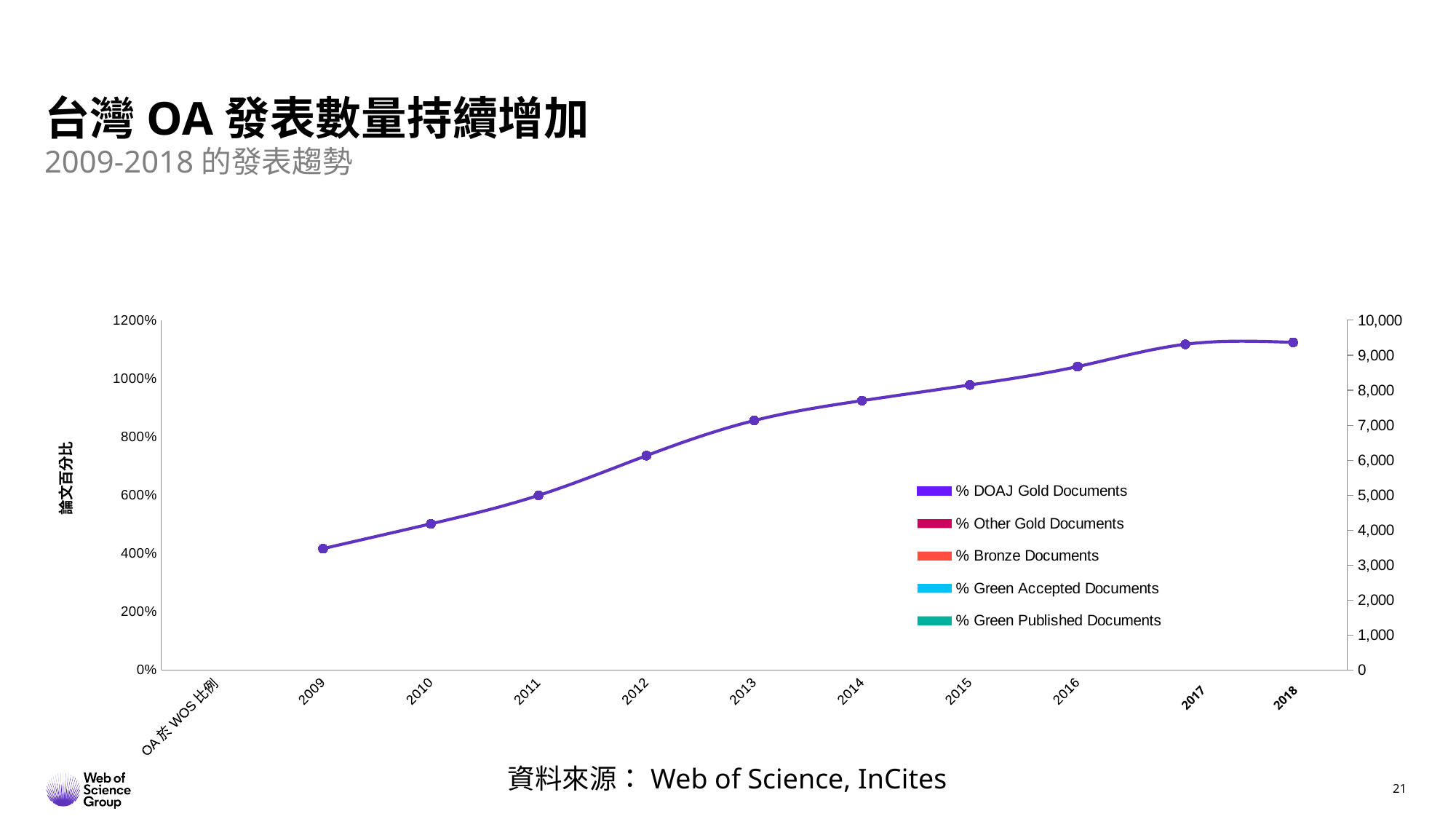
Which is larger, the value for 2012 or the value for 2011? 2012 What kind of chart is shown on the slide? line chart Which series is listed first in the chart's legend? % DOAJ Gold Documents What is the label on the left vertical axis of the chart? 論文百分比 Which year has the lowest value on the plotted line? 2009 Reading against the left-hand axis, is the value for 2014 greater or less than 800%? greater Does the plotted line rise or fall from 2009 to 2018? rise Reading against the right-hand axis, is the value for 2018 greater or less than 9,000? greater How many series does the chart's legend list? 5 Which is larger, the value for 2009 or the value for 2013? 2013 Reading against the right-hand axis, is the value for 2009 greater or less than 4,000? less How many years are plotted along the x axis of the chart? 10